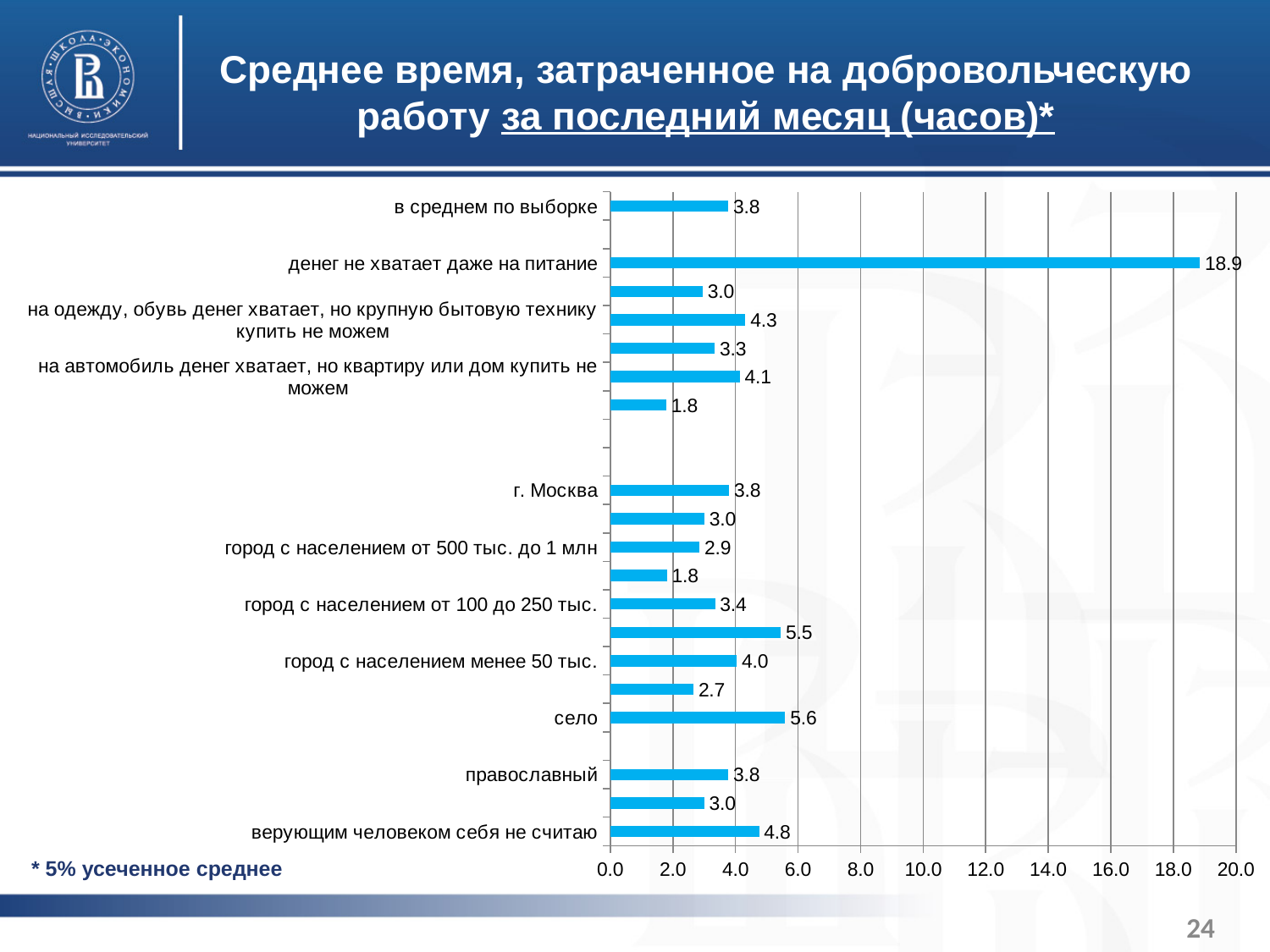
What is the value for "денег не хватает даже на питание"? 18.9 What is the value for "в среднем по выборке"? 3.8 What is the difference between the values for "верующим человеком себя не считаю" and "православный"? 1.0 What is the maximum value shown on the horizontal axis? 20.0 Which is larger: the value for "село" or for "город с населением менее 50 тыс."? село What is the difference between the values for "село" and "г. Москва"? 1.8 Which category has the highest value on the chart? денег не хватает даже на питание What is the value for "село"? 5.6 What kind of chart is shown on the slide? bar chart What is the value for "г. Москва"? 3.8 What is the value for "верующим человеком себя не считаю"? 4.8 Is the value for "денег не хватает даже на питание" greater or less than 18.0? greater